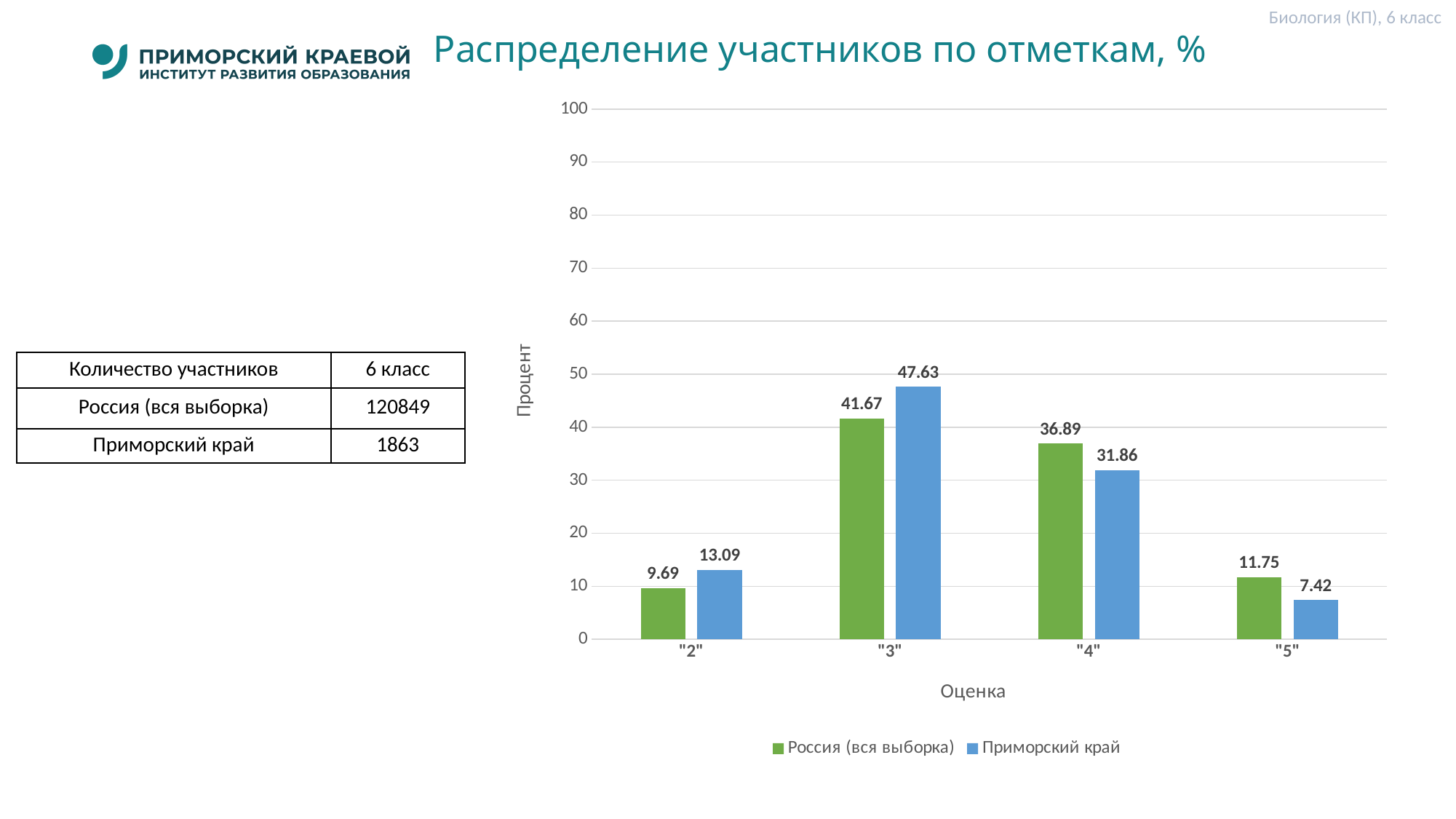
What is the difference between Приморский край and Россия (вся выборка) at grade "2"? 3.40 Which grade has the lowest value for Приморский край? "5" Which grade has the highest value for Россия (вся выборка)? "3" How many grade categories are shown on the x axis? 4 What kind of chart is shown on the slide? bar chart What is the value for Приморский край at grade "5"? 7.42 What is the value for Приморский край at grade "3"? 47.63 How many series does the legend list? 2 What is the value for Россия (вся выборка) at grade "4"? 36.89 Is the value for Приморский край at grade "3" greater or less than 40? greater What is the label of the y axis? Процент Which is larger at grade "4": Россия (вся выборка) or Приморский край? Россия (вся выборка)